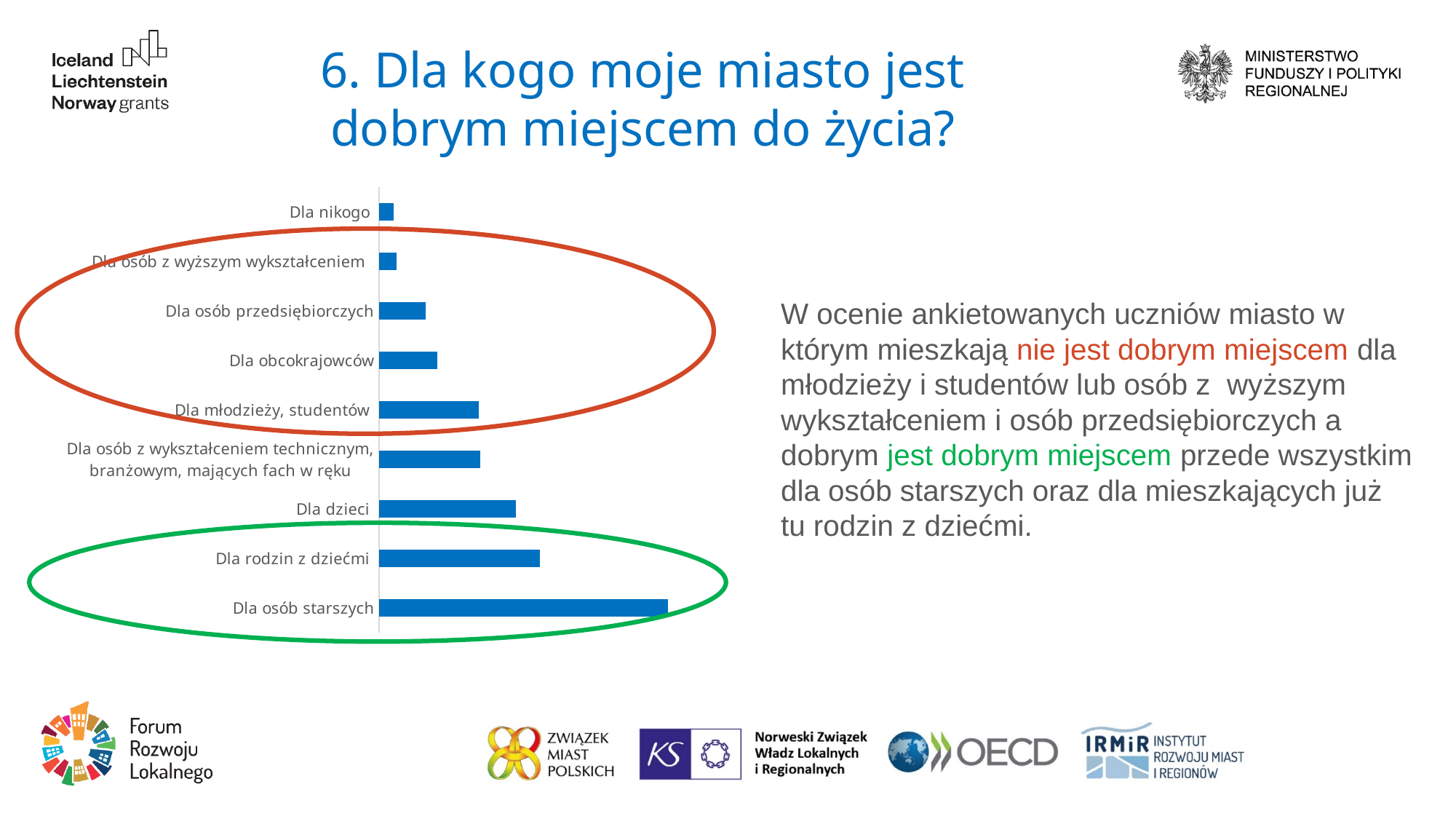
What kind of chart is shown on the slide? Bar chart Which two categories are enclosed by the green ellipse on the chart? Dla rodzin z dziećmi and Dla osób starszych Which bar is longer: "Dla dzieci" or "Dla osób przedsiębiorczych"? Dla dzieci Which bar is longer: "Dla obcokrajowców" or "Dla osób z wyższym wykształceniem"? Dla obcokrajowców Which bar is longer: "Dla rodzin z dziećmi" or "Dla dzieci"? Dla rodzin z dziećmi Which category has the longest bar in the chart? Dla osób starszych What colour are the bars in the chart? Blue How many categories does the bar chart show? 9